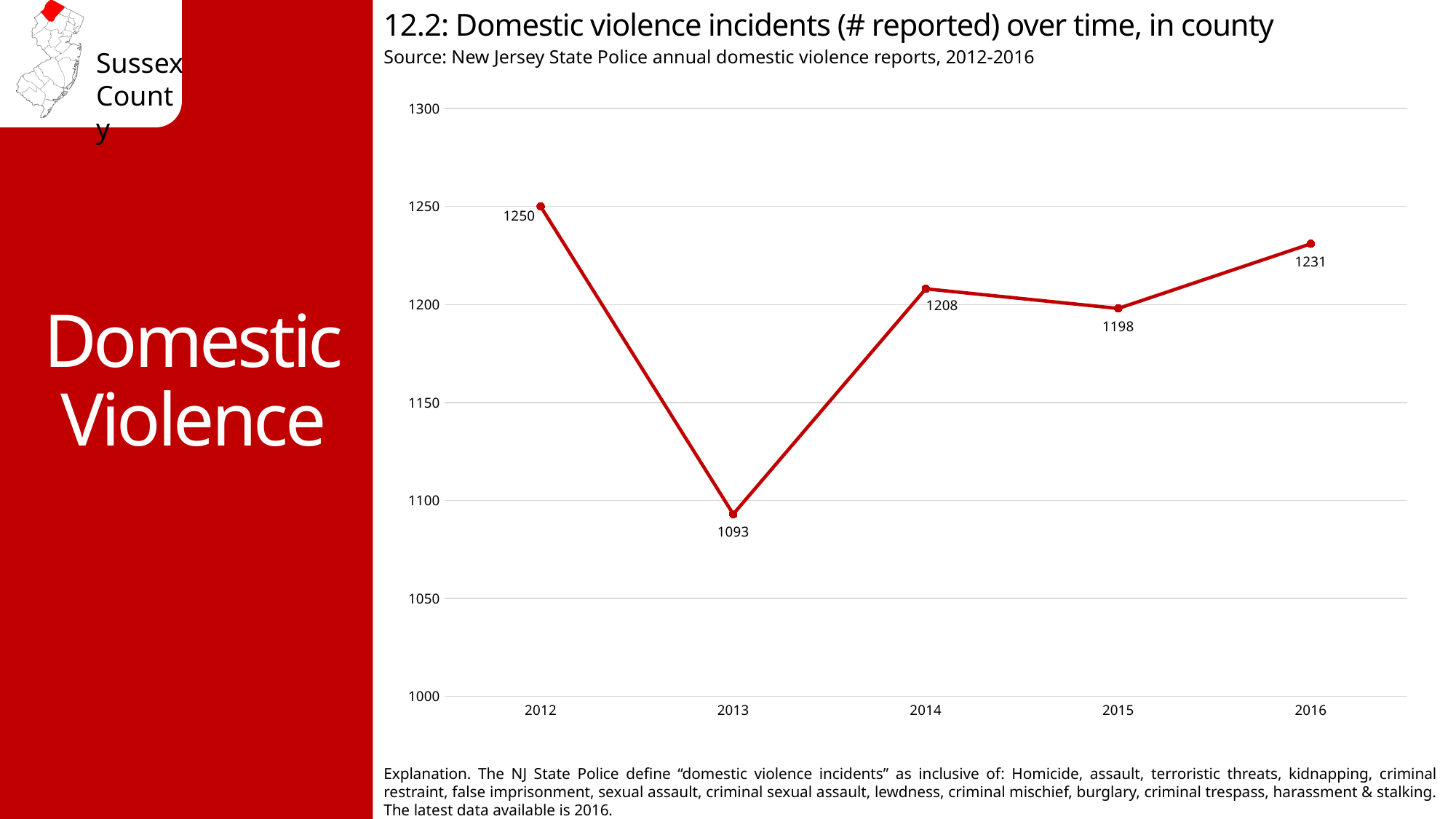
What type of chart is shown on the slide? line chart How many domestic violence incidents were reported in 2016? 1231 Is the value for 2013 greater or less than 1100? less How many domestic violence incidents were reported in 2013? 1093 Which year had more reported incidents, 2014 or 2015? 2014 Did the number of reported incidents rise or fall from 2013 to 2014? rise What is the difference between the number of incidents in 2012 and 2013? 157 How many years are plotted on the chart? 5 Which year had the highest number of reported domestic violence incidents? 2012 What is the difference between the number of incidents in 2016 and 2015? 33 How many domestic violence incidents were reported in 2012? 1250 Which year had the lowest number of reported domestic violence incidents? 2013